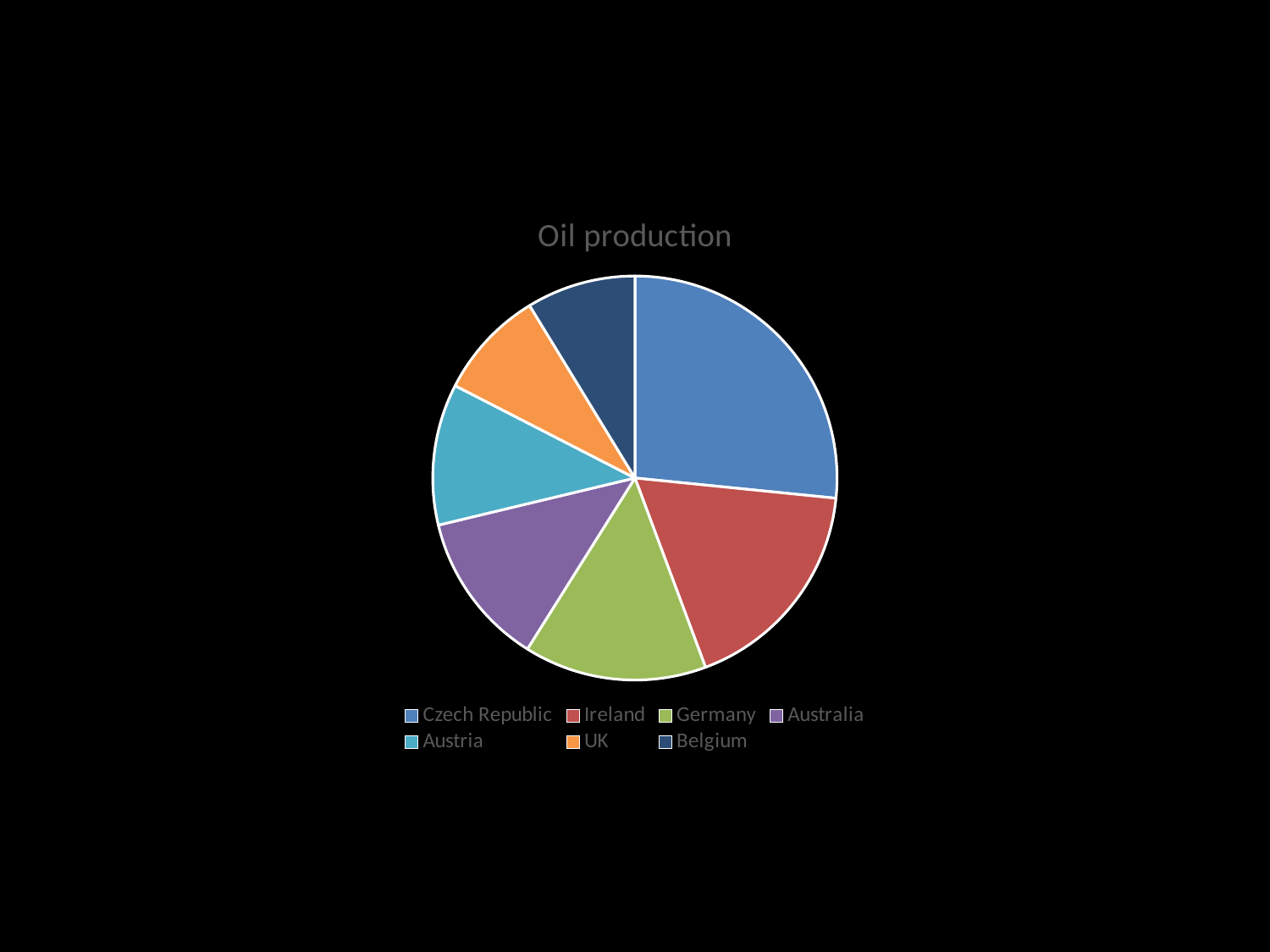
Which slice is larger, Ireland or UK? Ireland What colour is the slice for the UK? orange How many slices does the pie chart have? 7 What is the title of the chart? Oil production Which country has the largest slice of the pie? Czech Republic Which slice is larger, Czech Republic or Germany? Czech Republic Which slice is larger, Germany or Belgium? Germany What kind of chart is shown on the slide? pie chart How many entries does the legend list? 7